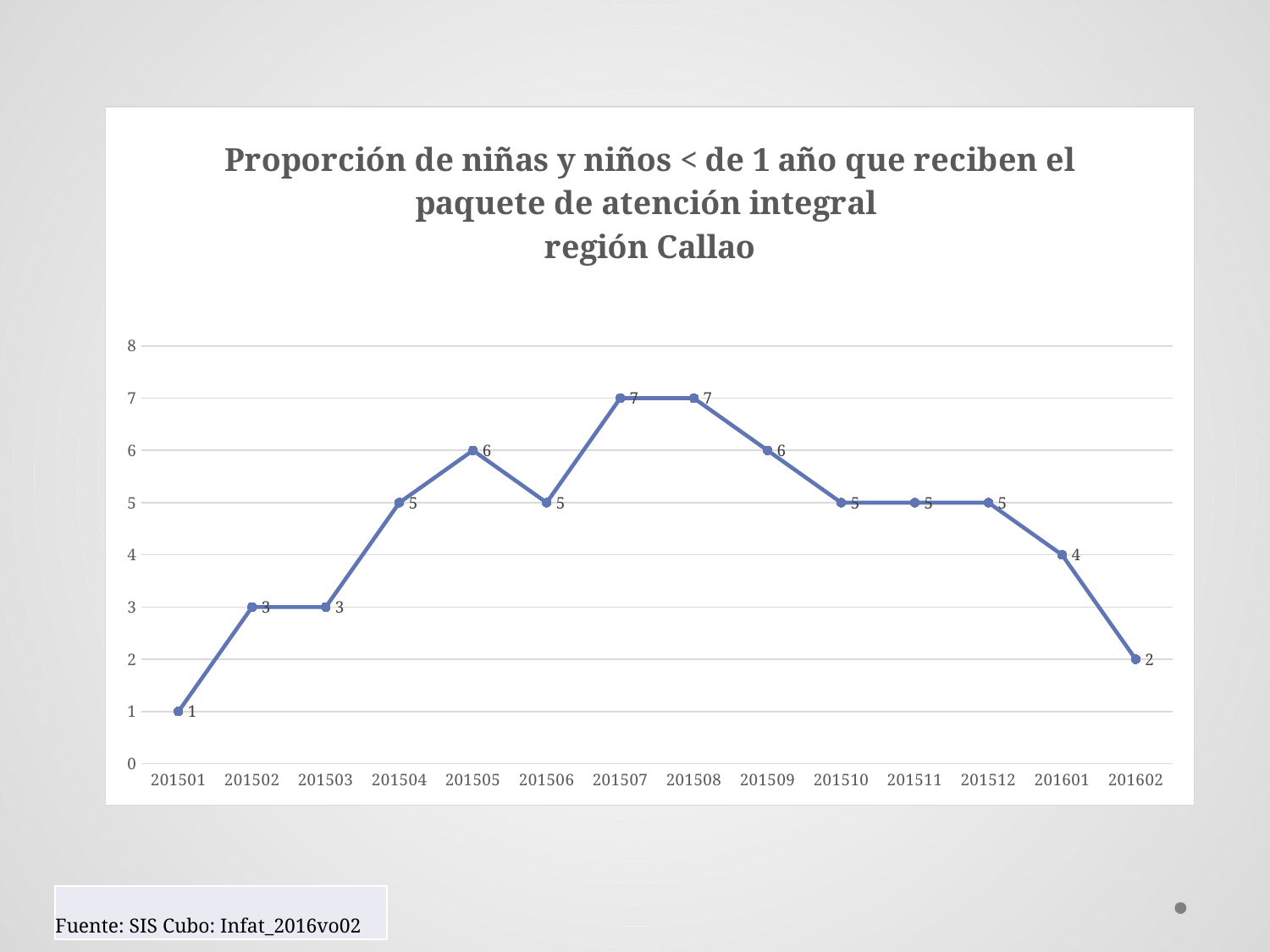
Do the values rise or fall from 201512 to 201602? Fall Which period has the lowest value? 201501 What is the value for 201505? 6 What is the highest value shown on the chart? 7 What is the difference between the values for 201507 and 201501? 6 What is the value for 201602? 2 What is the value for 201501? 1 What is the difference between the values for 201508 and 201509? 1 Which is larger, the value for 201504 or the value for 201601? 201504 What is the value for 201601? 4 How many data points are plotted on the chart? 14 What kind of chart is shown on the slide? Line chart